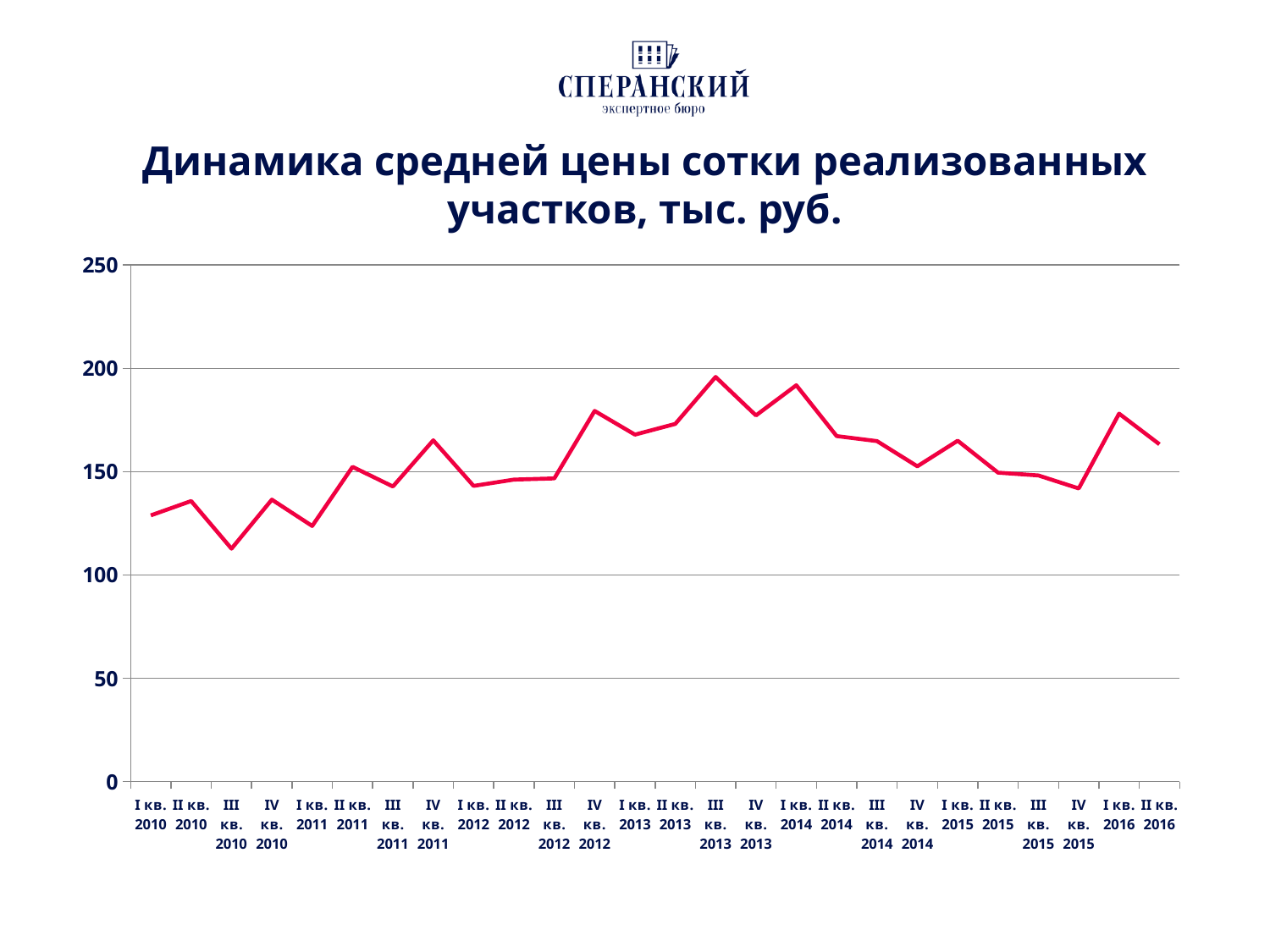
Is the value for III кв. 2013 greater or less than 200? less Is the value for III кв. 2010 greater or less than 100? greater Which is larger, the value for II кв. 2014 or the value for IV кв. 2014? II кв. 2014 Which is larger, the value for IV кв. 2011 or the value for I кв. 2012? IV кв. 2011 Does the average price generally rise or fall from I кв. 2010 to III кв. 2013? rise Which quarter has the lowest average price on the chart? III кв. 2010 Is the value for I кв. 2010 greater or less than 150? less How many quarterly data points are plotted on the chart? 26 Which quarter has the highest average price on the chart? III кв. 2013 What is the title of the chart? Динамика средней цены сотки реализованных участков, тыс. руб. What kind of chart is shown on the slide? line chart